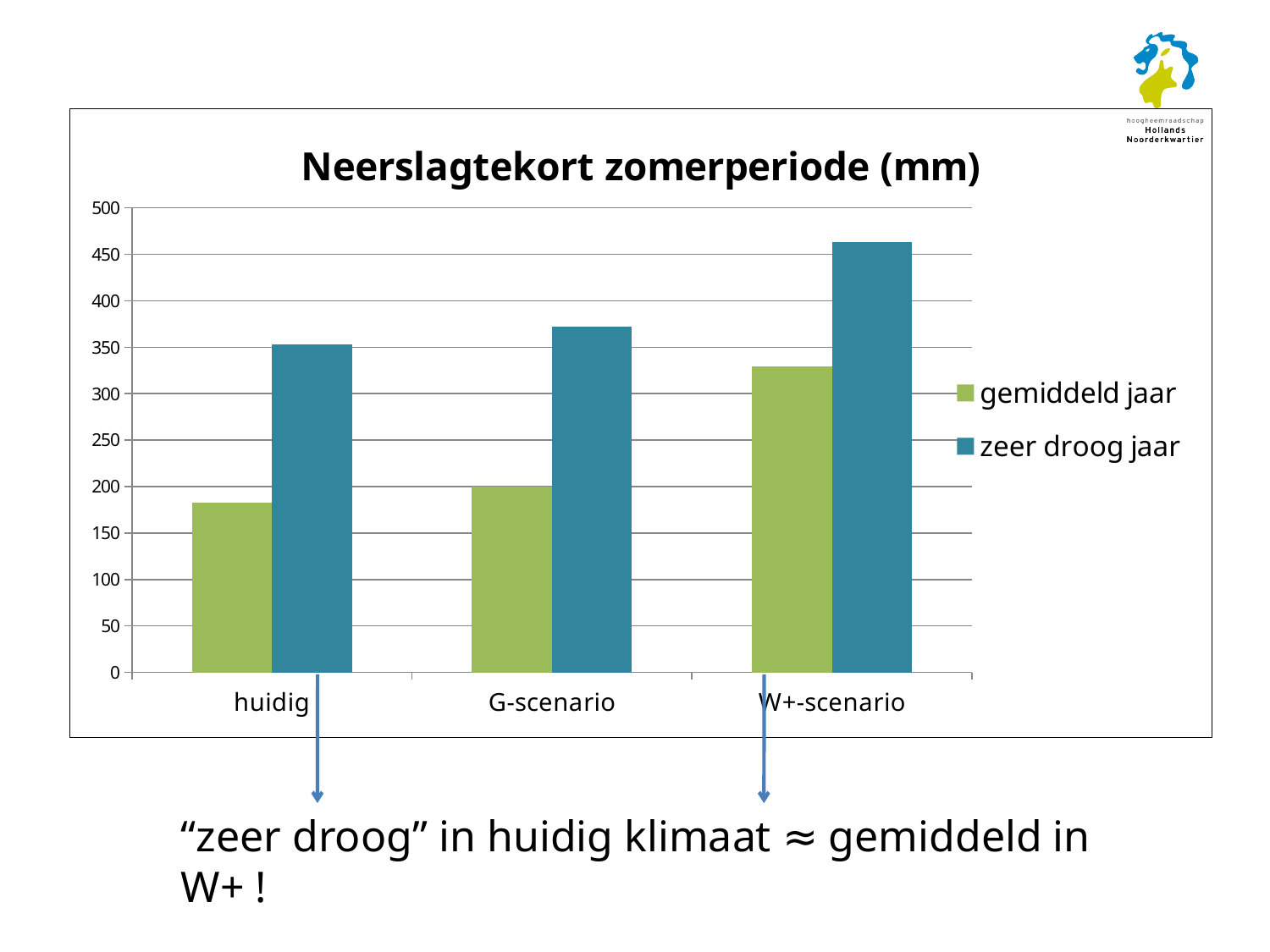
Which is larger: the 'zeer droog jaar' value for huidig or the 'gemiddeld jaar' value for G-scenario? zeer droog jaar for huidig Is the 'gemiddeld jaar' value for huidig greater or less than 200? less For which category is the 'gemiddeld jaar' value lowest? huidig Is the 'zeer droog jaar' value for W+-scenario greater or less than 400? greater How many series does the legend list? 2 What type of chart is shown on the slide? bar chart For which category is the 'zeer droog jaar' value highest? W+-scenario How many categories are shown on the x axis? 3 Do the 'gemiddeld jaar' values rise or fall from huidig to W+-scenario? rise Which colour represents the 'zeer droog jaar' series? blue What is the title of the chart? Neerslagtekort zomerperiode (mm) Is the 'zeer droog jaar' value for huidig greater or less than 300? greater